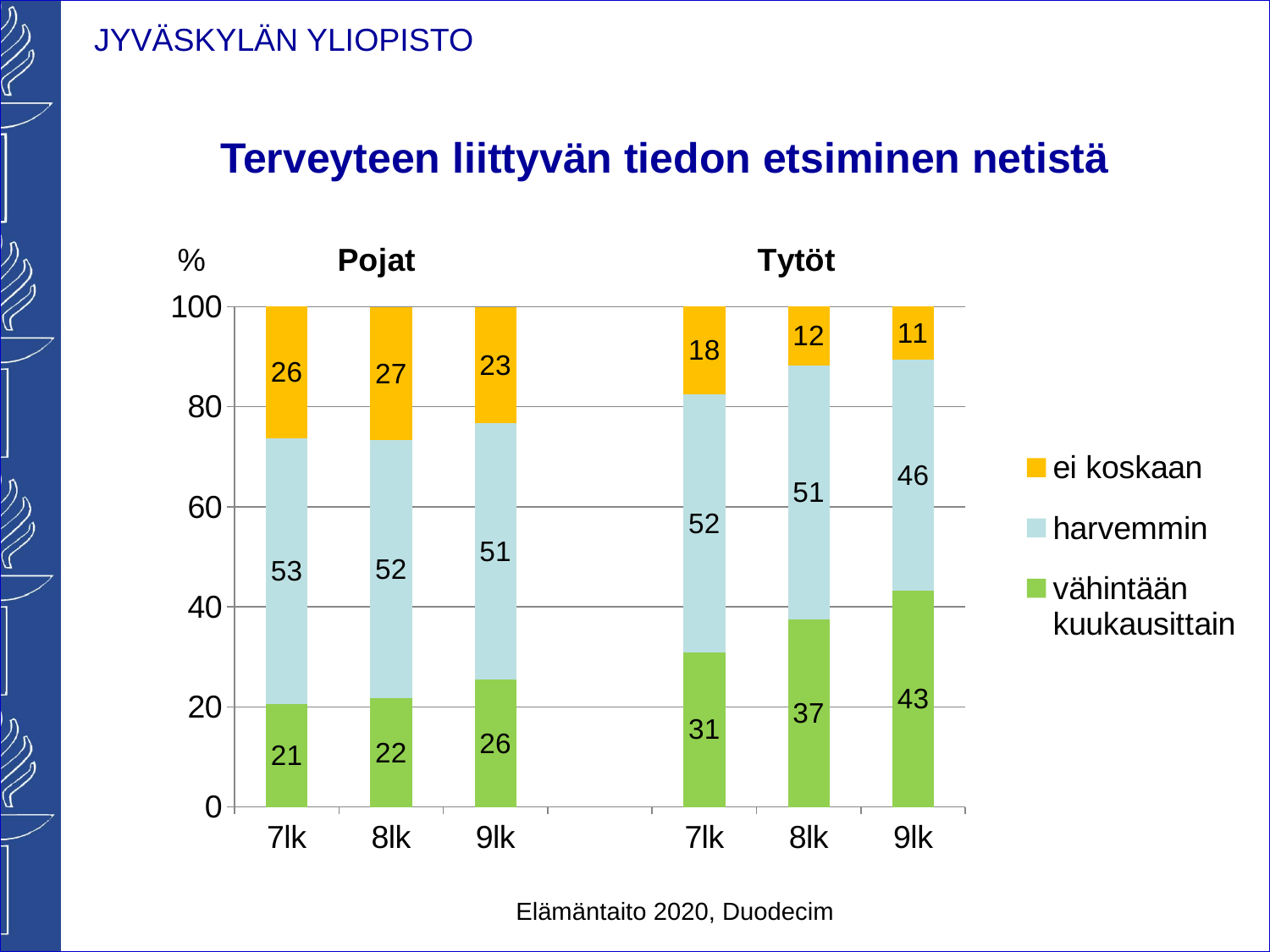
What is the total of the stacked bar for Pojat 9lk? 100 Which bar has the highest 'vähintään kuukausittain' value? Tytöt 9lk Which bar has the lowest 'ei koskaan' value? Tytöt 9lk What is the difference between the 'ei koskaan' values for Pojat 7lk and Tytöt 7lk? 8 Does the 'vähintään kuukausittain' value rise or fall from 7lk to 9lk among Tytöt? rise What kind of chart is shown on the slide? stacked bar chart What is the value of 'harvemmin' for Tytöt 7lk? 52 What is the value of 'ei koskaan' for Pojat 8lk? 27 Which is larger: the 'vähintään kuukausittain' value for Pojat 9lk or for Tytöt 8lk? Tytöt 8lk How many series does the legend list? 3 How many bars are plotted in the chart? 6 What is the value of 'vähintään kuukausittain' for Tytöt 9lk? 43